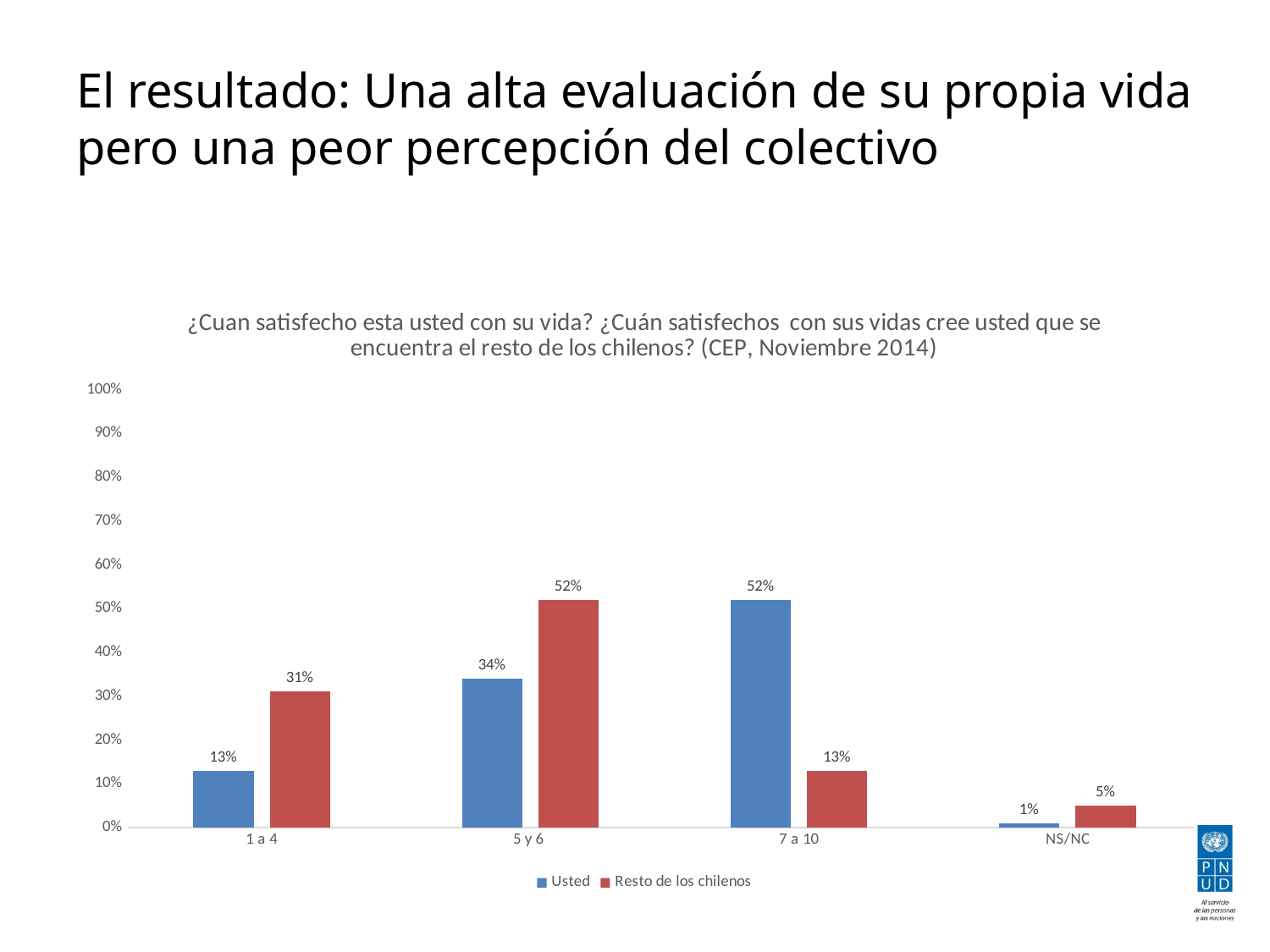
What is the value for "Usted" in the "1 a 4" category? 13% What is the value for "Resto de los chilenos" in the "NS/NC" category? 5% What is the difference between "Usted" and "Resto de los chilenos" in the "7 a 10" category? 39% Which colour represents the "Usted" series? Blue How many series does the legend list? 2 What is the value for "Resto de los chilenos" in the "5 y 6" category? 52% Which category has the highest value for the "Usted" series? 7 a 10 What is the value for "Usted" in the "7 a 10" category? 52% How many categories are shown on the x axis? 4 Which category has the lowest value for the "Resto de los chilenos" series? NS/NC What kind of chart is shown on the slide? Bar chart In the "1 a 4" category, which series has the larger value, "Usted" or "Resto de los chilenos"? Resto de los chilenos